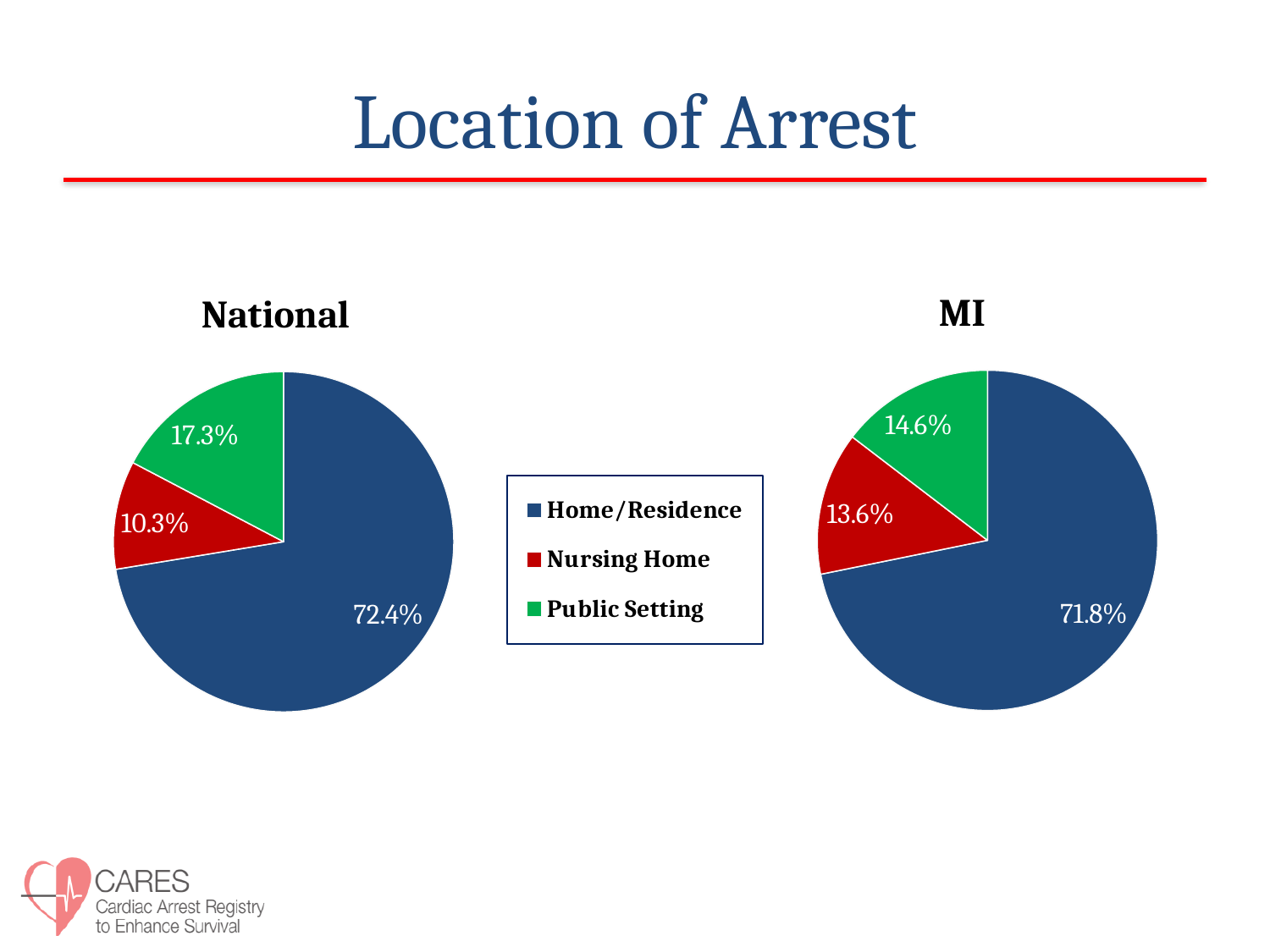
In the MI chart, what percentage of arrests occurred in a Nursing Home? 13.6% What is the difference between the Nursing Home share in the MI chart and the Nursing Home share in the National chart? 3.3% In the National chart, which location has the largest share? Home/Residence What type of chart is used to show the location of arrest? Pie chart In the National chart, what percentage of arrests occurred at Home/Residence? 72.4% In the MI chart, which location has the smallest share? Nursing Home In the National chart, which location has the smallest share? Nursing Home In the National chart, what percentage of arrests occurred in a Public Setting? 17.3% How many categories does the legend list? 3 In the MI chart, what percentage of arrests occurred in a Public Setting? 14.6% Is the Public Setting share larger in the National chart or the MI chart? National What colour represents Nursing Home in the charts? Red